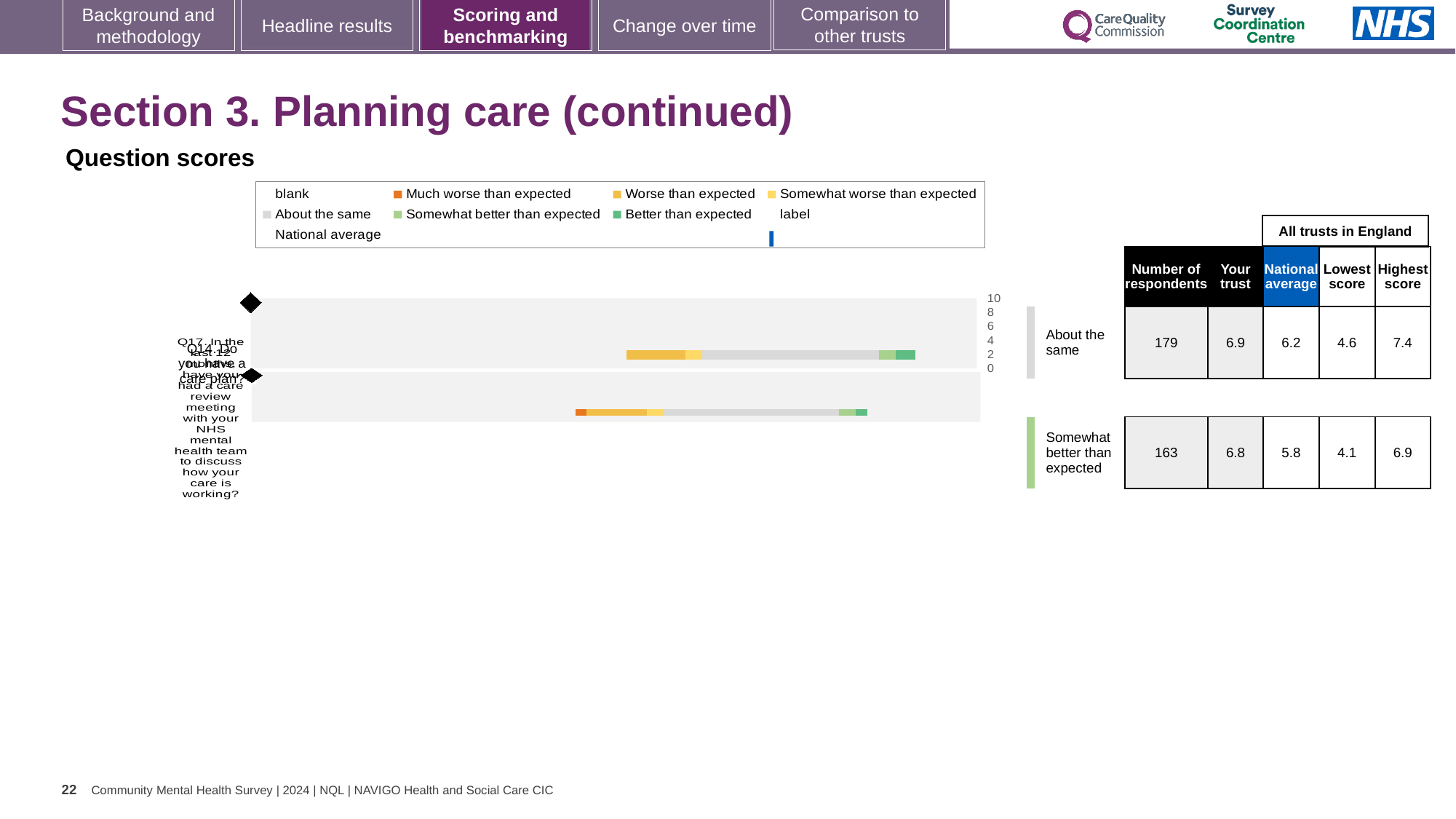
In the table next to the chart, what is the number of respondents for the row rated 'About the same'? 179 What kind of chart is shown on the slide? bar chart In the table next to the chart, what is the lowest score for the row rated 'Somewhat better than expected'? 4.1 In the table next to the chart, what is the 'Your trust' score for the row rated 'Somewhat better than expected'? 6.8 In the table next to the chart, which row has the larger number of respondents: 'About the same' or 'Somewhat better than expected'? About the same In the table next to the chart, what is the highest score for the row rated 'About the same'? 7.4 In the table next to the chart, what is the difference between the 'Your trust' score and the national average for the row rated 'Somewhat better than expected'? 1.0 What is the highest value shown on the chart's axis? 10 How many bars (questions) are plotted in the chart? 2 In the table next to the chart, what is the national average for the row rated 'About the same'? 6.2 In the table next to the chart, what is the difference between the highest score and the lowest score for the row rated 'About the same'? 2.8